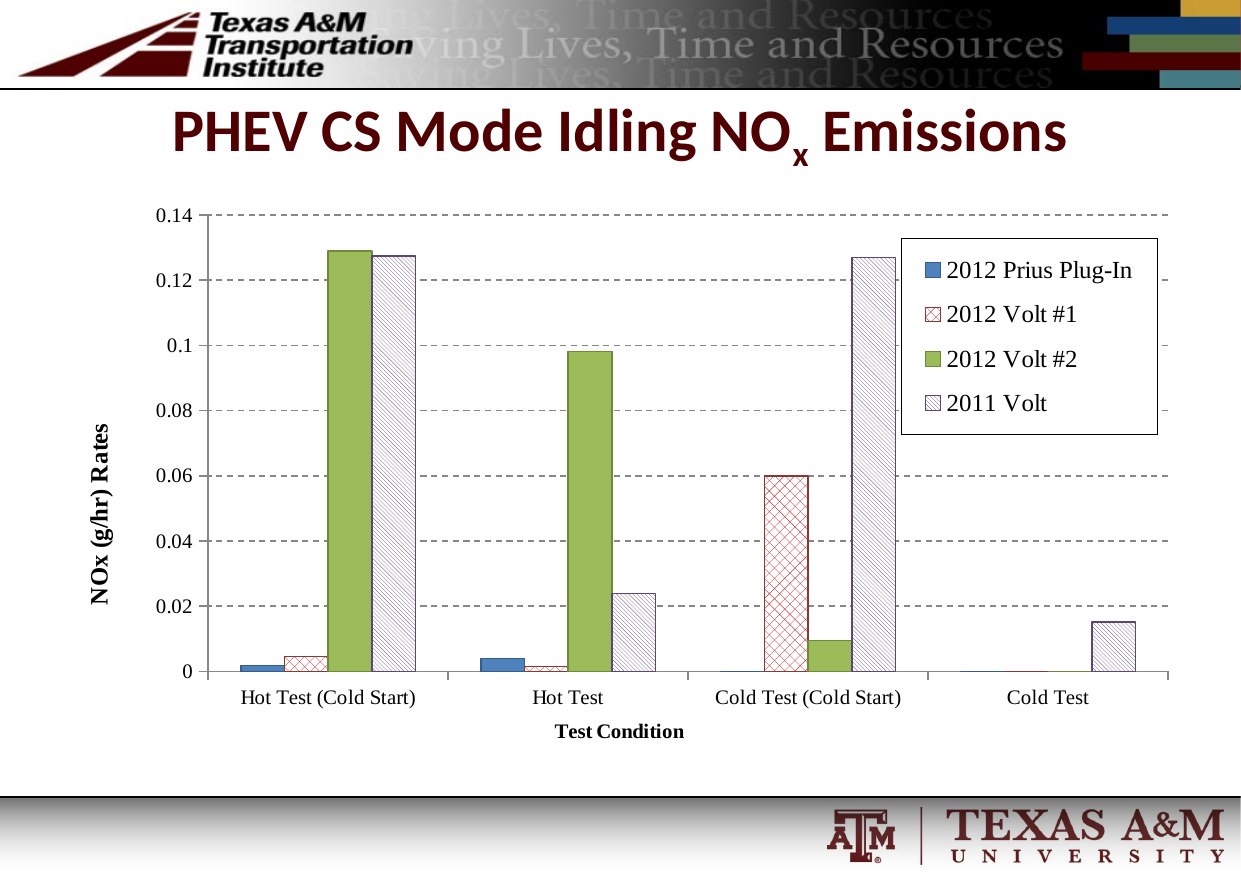
What is the label on the y axis of the chart? NOx (g/hr) Rates What kind of chart is shown on the slide? bar chart How many series does the legend list? 4 For 2012 Volt #2, which condition has the larger value: Hot Test (Cold Start) or Hot Test? Hot Test (Cold Start) Which series has the highest value for the Hot Test condition? 2012 Volt #2 In the Cold Test (Cold Start) condition, which is larger: 2012 Volt #1 or 2012 Volt #2? 2012 Volt #1 Is the value for 2012 Volt #2 in the Hot Test (Cold Start) condition greater or less than 0.12? greater Is the value for 2012 Volt #2 in the Hot Test condition greater or less than 0.08? greater Which series has the highest value for the Cold Test (Cold Start) condition? 2011 Volt Is the value for 2012 Volt #1 in the Cold Test (Cold Start) condition greater or less than 0.04? greater How many test conditions are shown on the x axis? 4